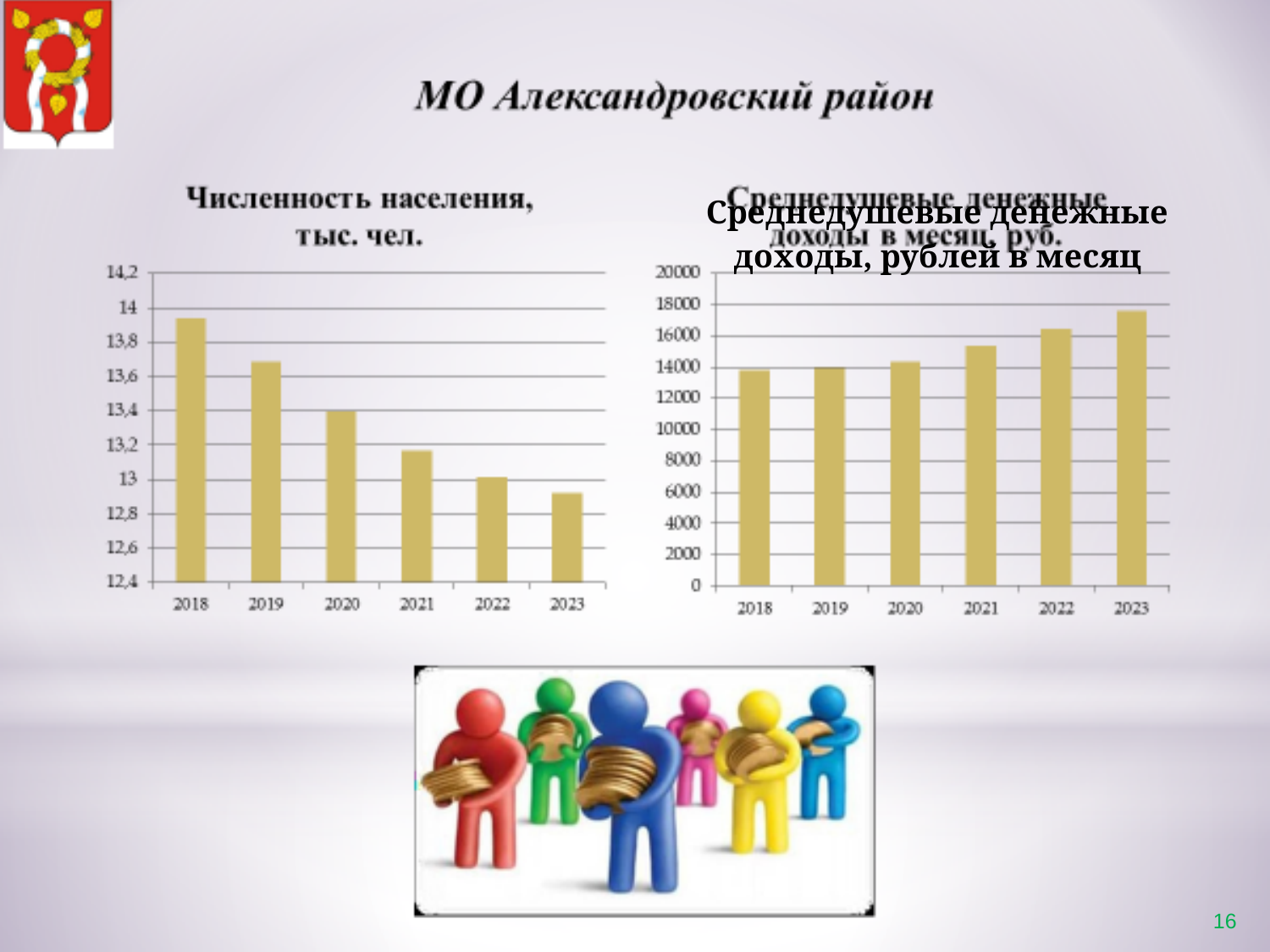
In the right chart "Среднедушевые денежные доходы, рублей в месяц", which year has the highest value? 2023 In the left chart "Численность населения, тыс. чел.", which year has the lowest value? 2023 In the right chart "Среднедушевые денежные доходы, рублей в месяц", which is larger, the value for 2018 or the value for 2021? 2021 In the left chart "Численность населения, тыс. чел.", is the value for 2023 greater or less than 13? less What is the title of the left chart on the slide? Численность населения, тыс. чел. In the left chart "Численность населения, тыс. чел.", do the values rise or fall from 2018 to 2023? fall In the right chart "Среднедушевые денежные доходы, рублей в месяц", do the values rise or fall from 2018 to 2023? rise In the left chart "Численность населения, тыс. чел.", which year has the highest value? 2018 In the right chart "Среднедушевые денежные доходы, рублей в месяц", is the value for 2022 greater or less than 16000? greater What kind of chart is the left chart titled "Численность населения, тыс. чел."? bar chart In the left chart "Численность населения, тыс. чел.", is the value for 2020 greater or less than 13,2? greater How many years are shown on the x axis of the left chart "Численность населения, тыс. чел."? 6